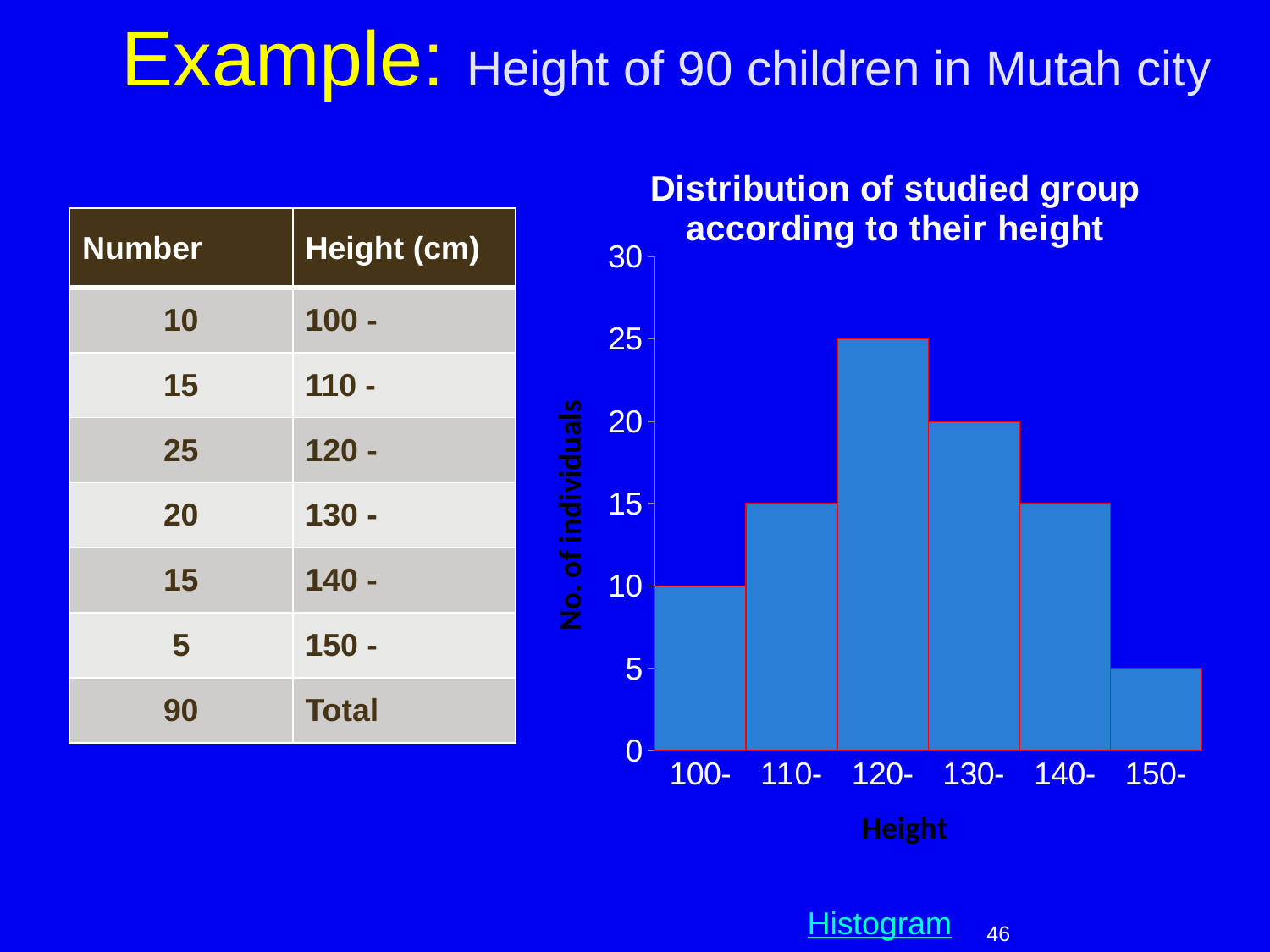
What is the title of the chart? Distribution of studied group according to their height What kind of chart is shown on the slide? Bar chart (histogram) What is the number of individuals in the 100- height group? 10 Is the value for the 130- height group greater or less than 15? greater Which height group has more individuals, 110- or 130-? 130- What is the number of individuals in the 150- height group? 5 What is the number of individuals in the 120- height group? 25 What is the label of the y axis of the chart? No. of individuals Which height group has the lowest number of individuals? 150- Which height group has the highest number of individuals? 120- What is the difference in number of individuals between the 120- and 130- height groups? 5 How many height groups are shown on the x axis of the chart? 6